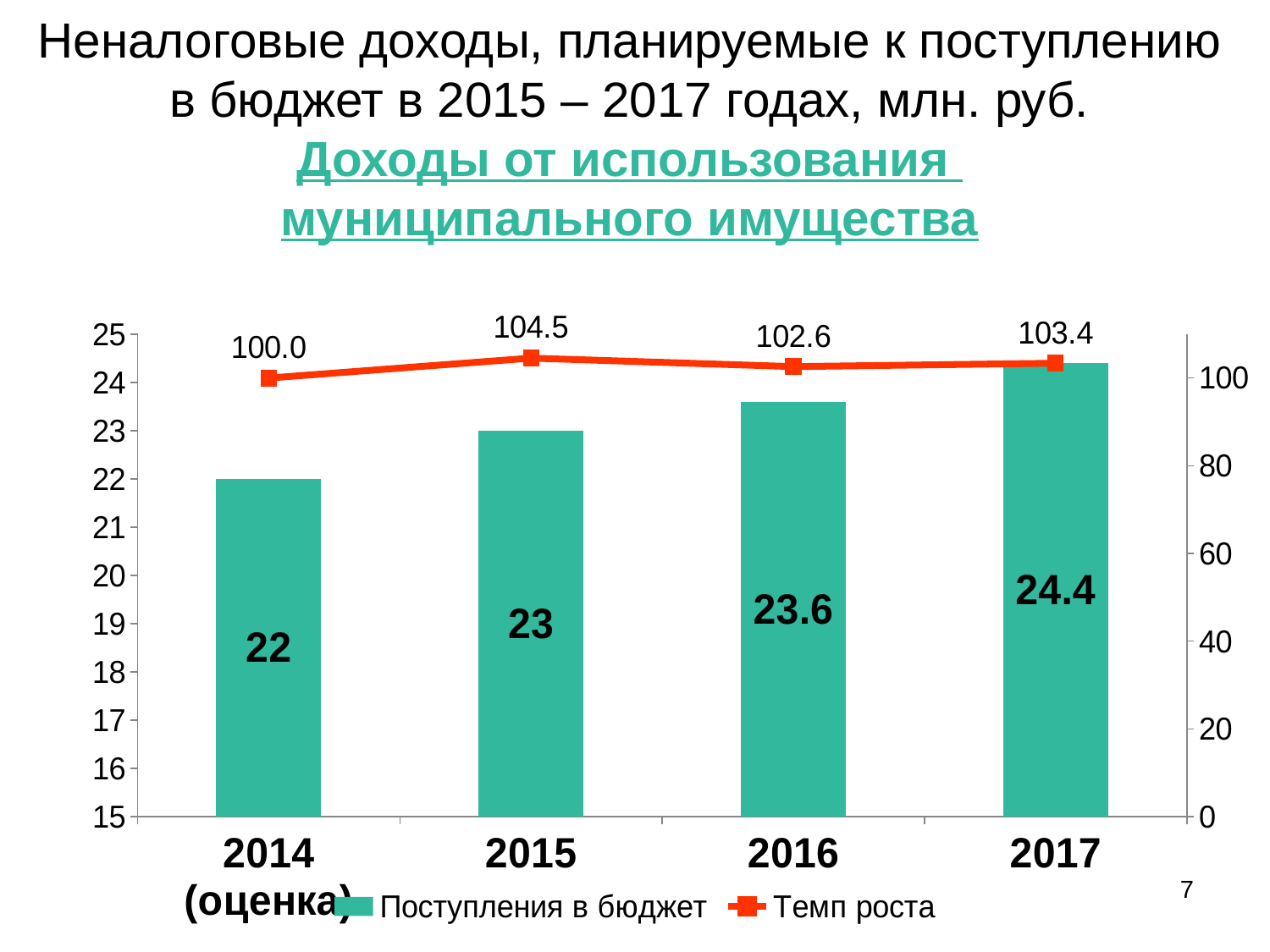
How many series does the legend list? 2 Do the values of 'Поступления в бюджет' rise or fall from 2014 to 2017? rise Is the value of 'Поступления в бюджет' for 2016 greater or less than 23? greater What is the difference between 'Поступления в бюджет' in 2017 and 2014? 2.4 Which year has the lowest value of 'Темп роста'? 2014 (оценка) Which is larger, 'Темп роста' in 2015 or in 2017? 2015 What kind of chart is used for the 'Поступления в бюджет' series? bar chart What is the value of 'Поступления в бюджет' for 2017? 24.4 What is the value of 'Поступления в бюджет' for 2015? 23 Which year has the highest value of 'Поступления в бюджет'? 2017 How many years are shown on the x axis? 4 What is the value of 'Темп роста' for 2016? 102.6